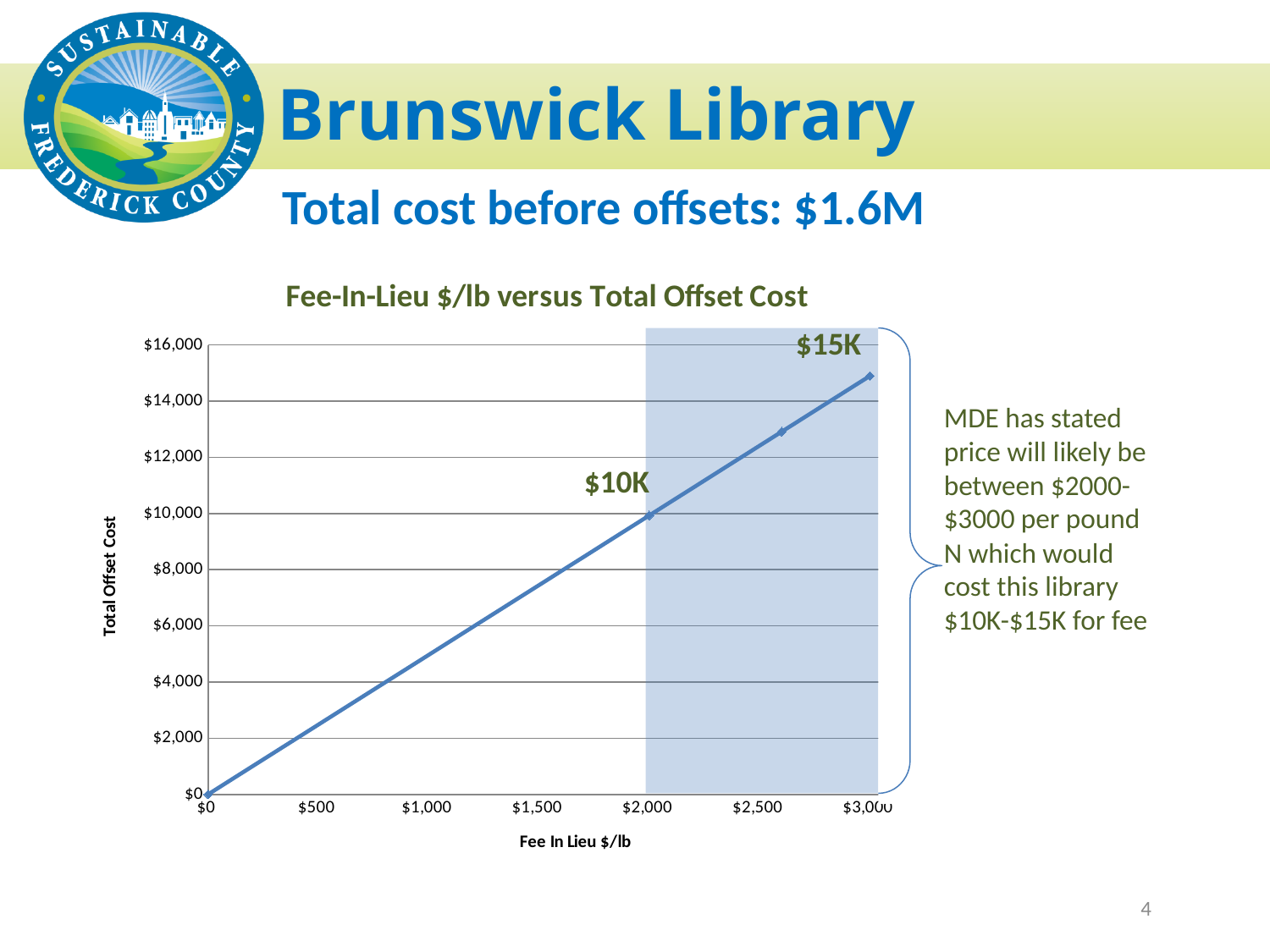
Is the Total Offset Cost at a fee of $1,000 greater or less than $4,000? greater What is the label of the x axis of the chart? Fee In Lieu $/lb Is the Total Offset Cost at a fee of $1,000 greater or less than $6,000? less Is the Total Offset Cost at a fee of $2,500 greater or less than $14,000? less What is the highest value shown on the y axis of the chart? $16,000 What label is printed on the chart near the point at a fee of $3,000? $15K Which has the larger Total Offset Cost: a fee of $2,000 or a fee of $3,000? $3,000 Does the Total Offset Cost rise or fall as the Fee In Lieu $/lb increases? rise What is the title of the chart? Fee-In-Lieu $/lb versus Total Offset Cost What type of chart is shown on the slide? line chart What label is printed on the chart near the point at a fee of $2,000? $10K